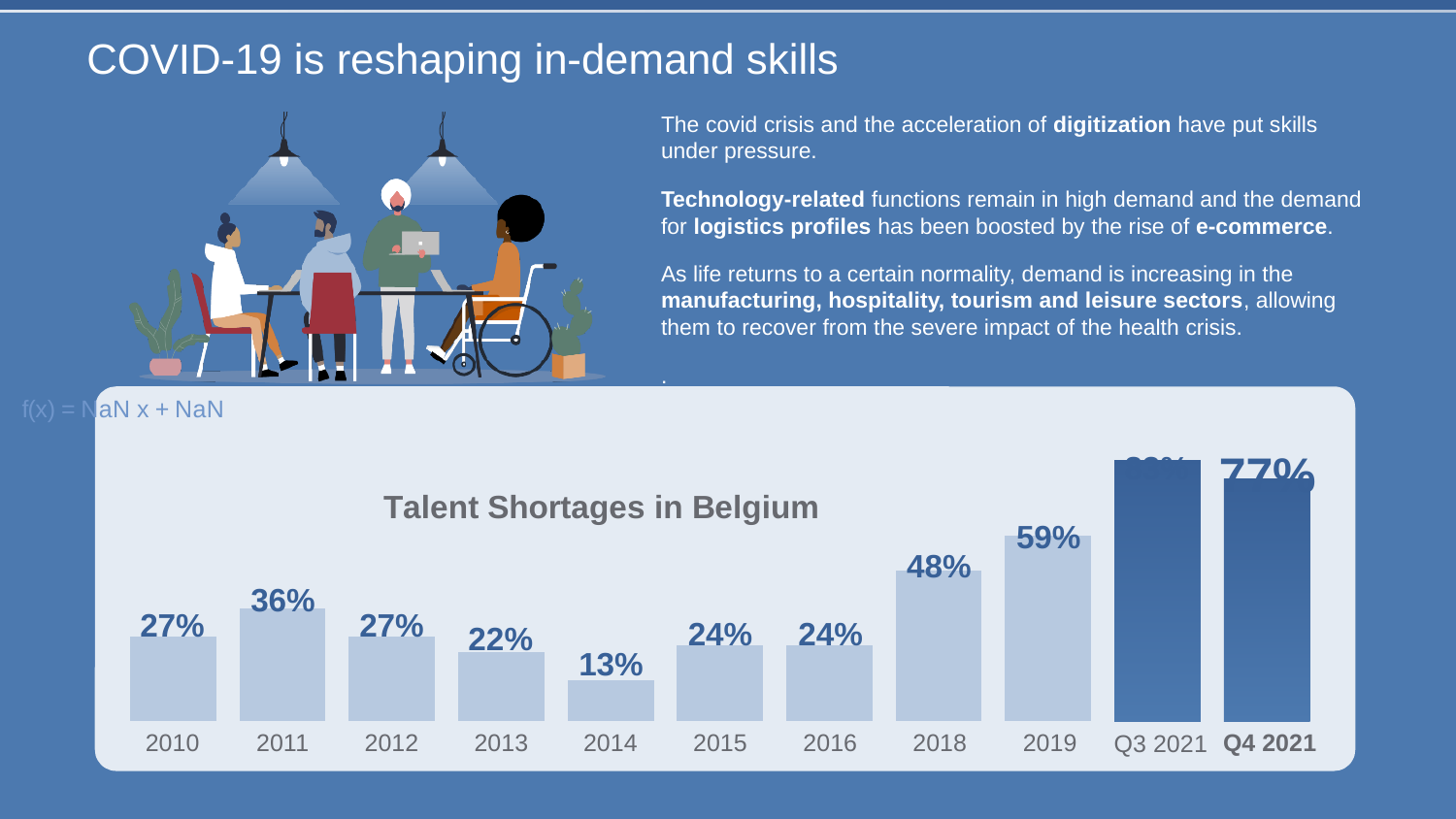
Which is larger in the Talent Shortages in Belgium chart, the value for 2011 or the value for 2013? 2011 What is the value for 2014 in the Talent Shortages in Belgium chart? 13% What is the value for Q4 2021 in the Talent Shortages in Belgium chart? 77% Which category has the lowest value in the Talent Shortages in Belgium chart? 2014 What is the difference between the values for Q4 2021 and 2019 in the Talent Shortages in Belgium chart? 18% Which is larger in the Talent Shortages in Belgium chart, the value for 2018 or the value for 2016? 2018 What is the difference between the values for 2019 and 2018 in the Talent Shortages in Belgium chart? 11% What is the value for 2019 in the Talent Shortages in Belgium chart? 59% How many categories are shown on the x axis of the Talent Shortages in Belgium chart? 11 Do the values in the Talent Shortages in Belgium chart rise or fall from 2014 to 2019? rise What kind of chart is the Talent Shortages in Belgium chart? bar chart What is the value for 2011 in the Talent Shortages in Belgium chart? 36%